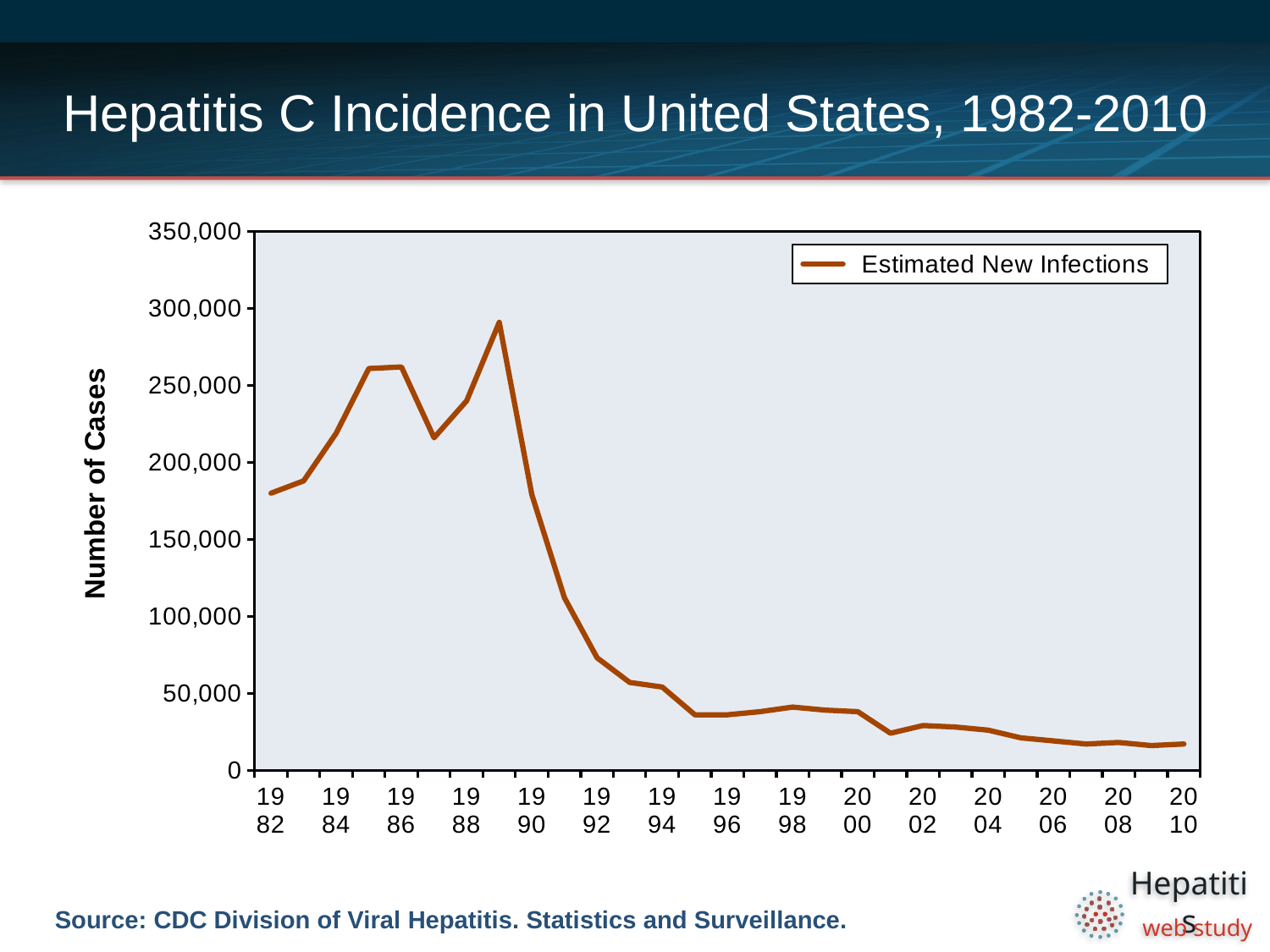
In which year does the number of estimated new infections reach its highest point? 1989 Does the number of estimated new infections rise or fall between 1989 and 1995? fall Is the value for 1982 greater or less than 150,000? greater Is the value for 2010 greater or less than 50,000? less How many series does the legend list? 1 What is the label of the y axis? Number of Cases Which year has the larger value, 1985 or 1987? 1985 Which year has the larger value, 1982 or 2010? 1982 Is the value for 1992 greater or less than 100,000? less What is the name of the series shown in the legend? Estimated New Infections What kind of chart is shown on the slide? line chart